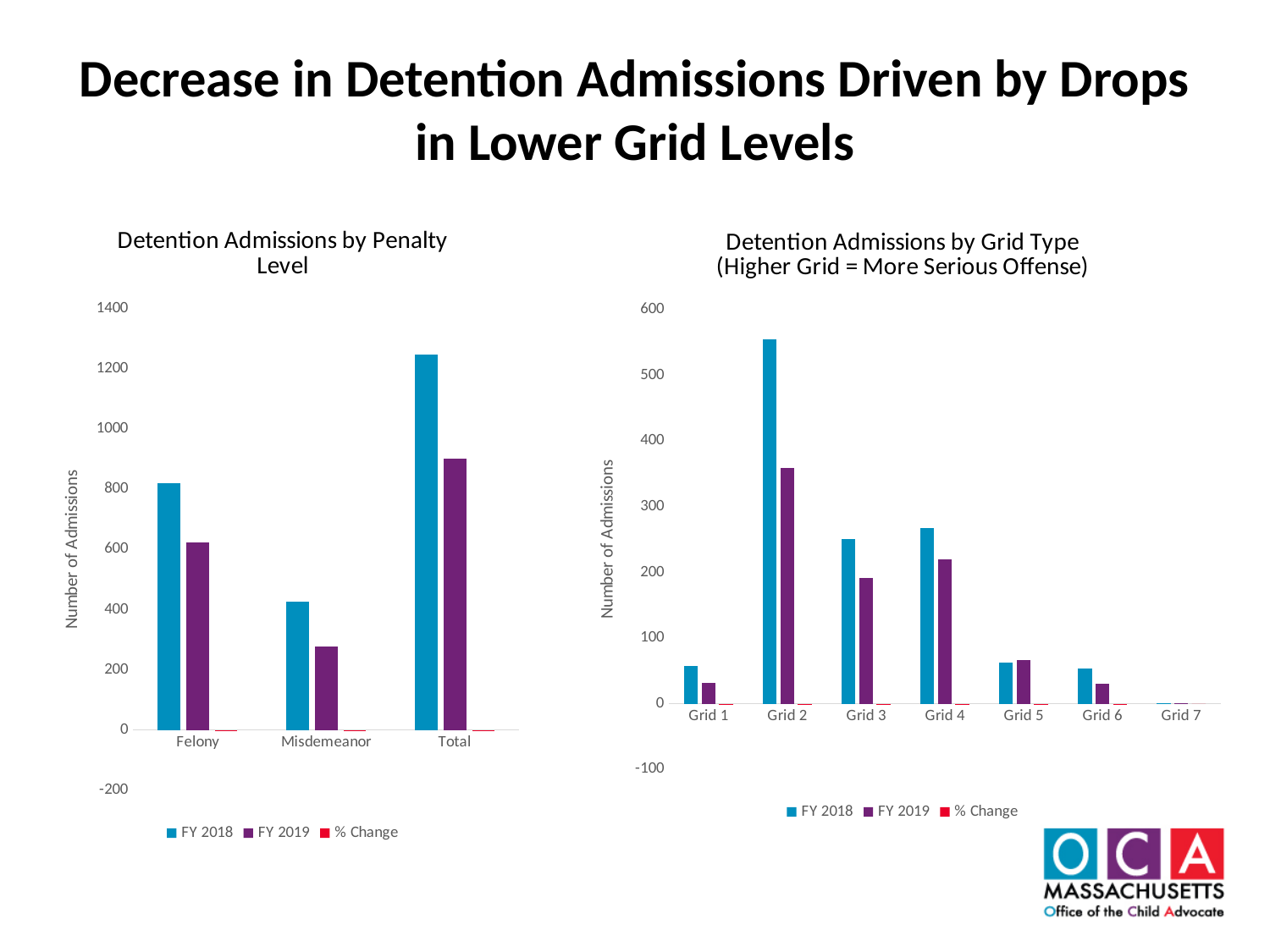
How many series does the legend of the 'Detention Admissions by Penalty Level' chart list? 3 In the 'Detention Admissions by Grid Type' chart, is the FY 2018 value for Grid 2 greater or less than 500? greater In the 'Detention Admissions by Grid Type' chart, which grid has the highest FY 2018 value? Grid 2 What are the legend entries of the 'Detention Admissions by Grid Type' chart? FY 2018, FY 2019, % Change How many grid categories are shown on the x axis of the 'Detention Admissions by Grid Type' chart? 7 In the 'Detention Admissions by Grid Type' chart, is the FY 2018 value for Grid 1 greater or less than 100? less In the 'Detention Admissions by Penalty Level' chart, is the FY 2018 value for Felony greater or less than 600? greater In the 'Detention Admissions by Grid Type' chart, which is larger for FY 2019: Grid 2 or Grid 3? Grid 2 What kind of chart is the 'Detention Admissions by Penalty Level' chart? bar chart In the 'Detention Admissions by Penalty Level' chart, which is larger for Felony: FY 2018 or FY 2019? FY 2018 In the 'Detention Admissions by Grid Type' chart, which grid has the lowest FY 2018 value? Grid 7